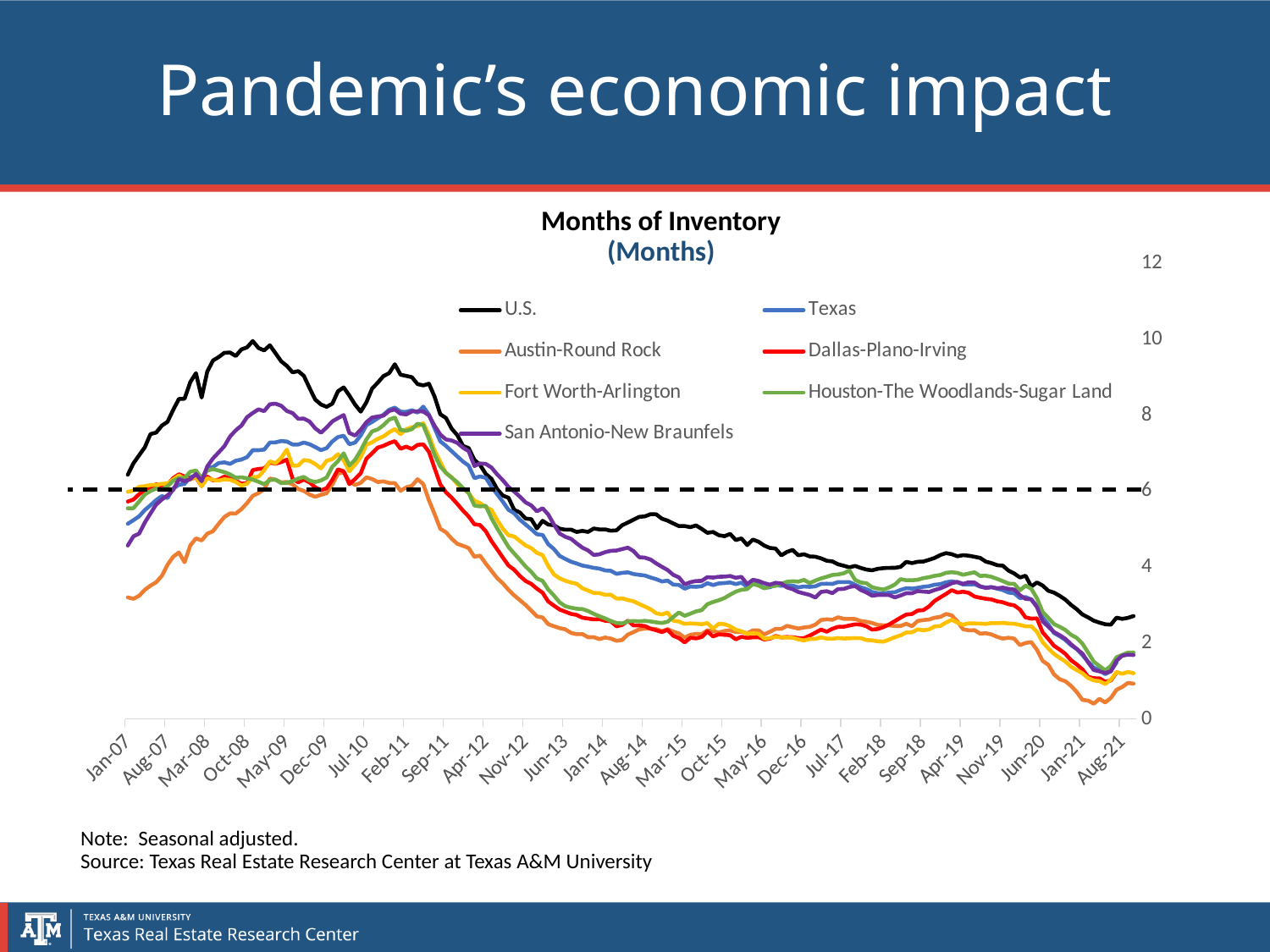
Is the Austin-Round Rock value around Jan-21 greater or less than 2? less Is the U.S. value at Aug-21 greater or less than 2? greater Around Oct-08, which is larger: the U.S. value or the Austin-Round Rock value? U.S. Which series has the lowest months of inventory around Jan-21? Austin-Round Rock Is the Houston-The Woodlands-Sugar Land value around Jan-14 greater or less than 4? less At what value on the y axis is the horizontal dashed line drawn? 6 Does the U.S. series rise or fall between Feb-11 and Jan-14? fall What type of chart is shown on the slide? line chart What is the title of the chart? Months of Inventory How many series does the legend of the Months of Inventory chart list? 7 Which series has the highest months of inventory around Oct-08? U.S.